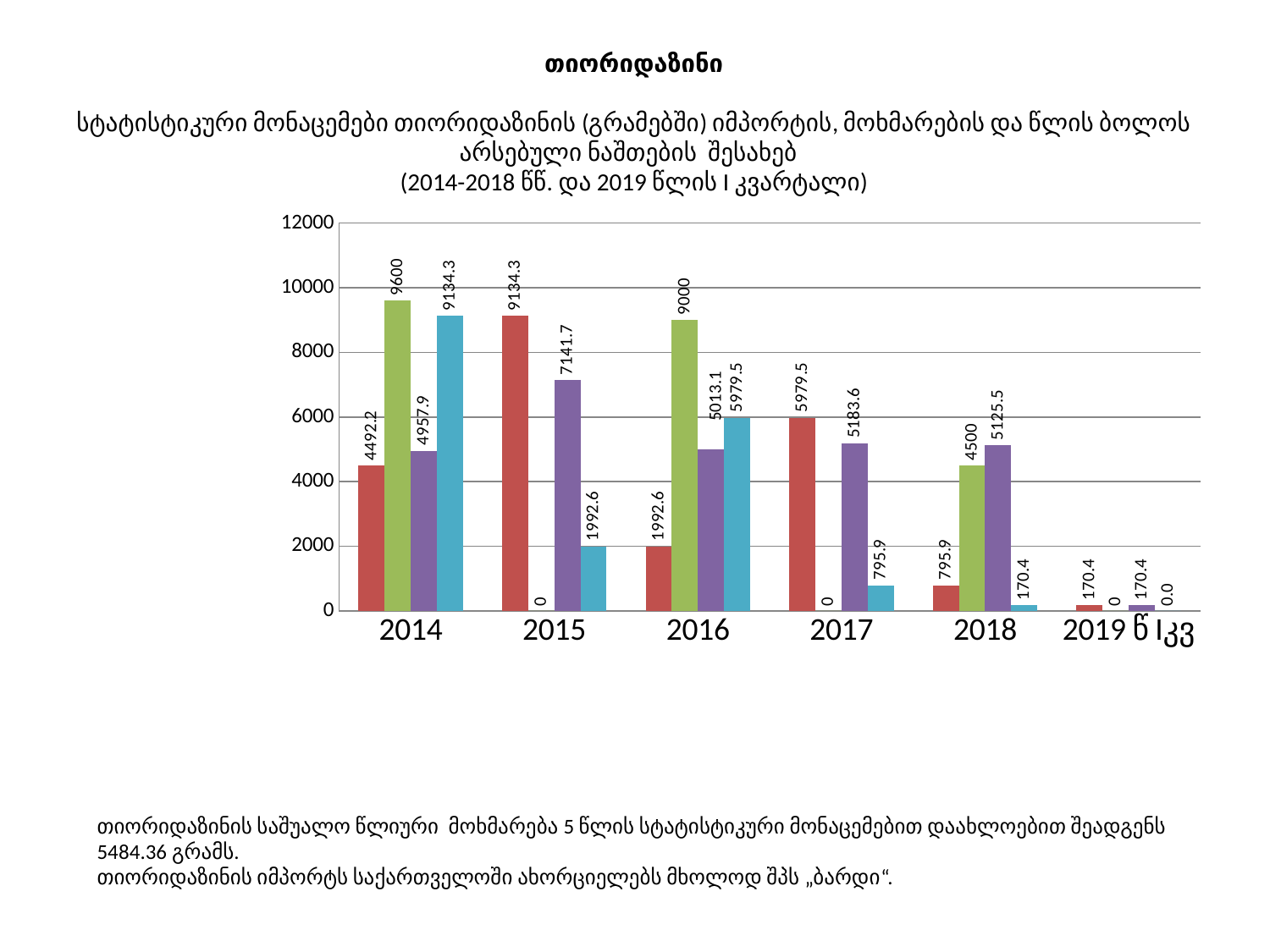
What is the value of the green bar for 2014? 9600 Which year has the highest green bar? 2014 How many bars are plotted for the 2014 category? 4 What is the value of the blue bar for 2018? 170.4 What is the value of the red bar for 2017? 5979.5 What kind of chart is shown on the slide? bar chart What is the title shown at the top of the slide? თიორიდაზინი What is the value of the purple bar for 2015? 7141.7 What is the difference between the green bar for 2014 and the green bar for 2016? 600 Which is larger: the red bar for 2015 or the red bar for 2016? the red bar for 2015 Which category has the lowest purple bar? 2019 წ I კვ How many categories are shown along the x axis of the chart? 6